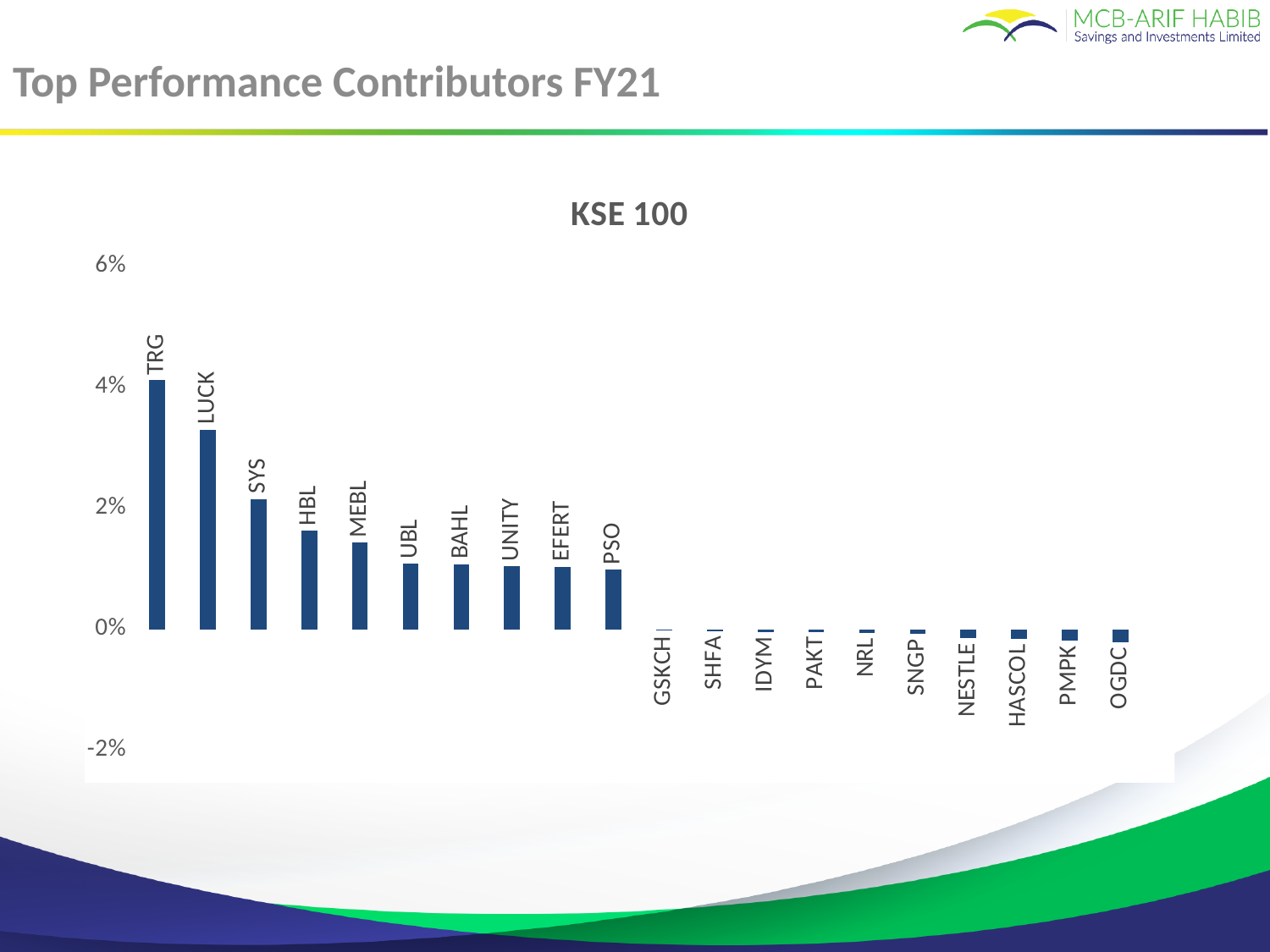
Is the value for TRG greater or less than 2%? greater Which has a larger value, SYS or PSO? SYS Which has a larger value, TRG or LUCK? TRG Is the value for OGDC greater or less than 0%? less What type of chart is shown on the slide? bar chart Do the values rise or fall moving from left to right along the x axis? fall Which category has the highest value in the chart? TRG Which category is plotted first on the left of the x axis? TRG What is the title of the chart? KSE 100 Is the value for LUCK greater or less than 4%? less How many categories are plotted in the chart? 20